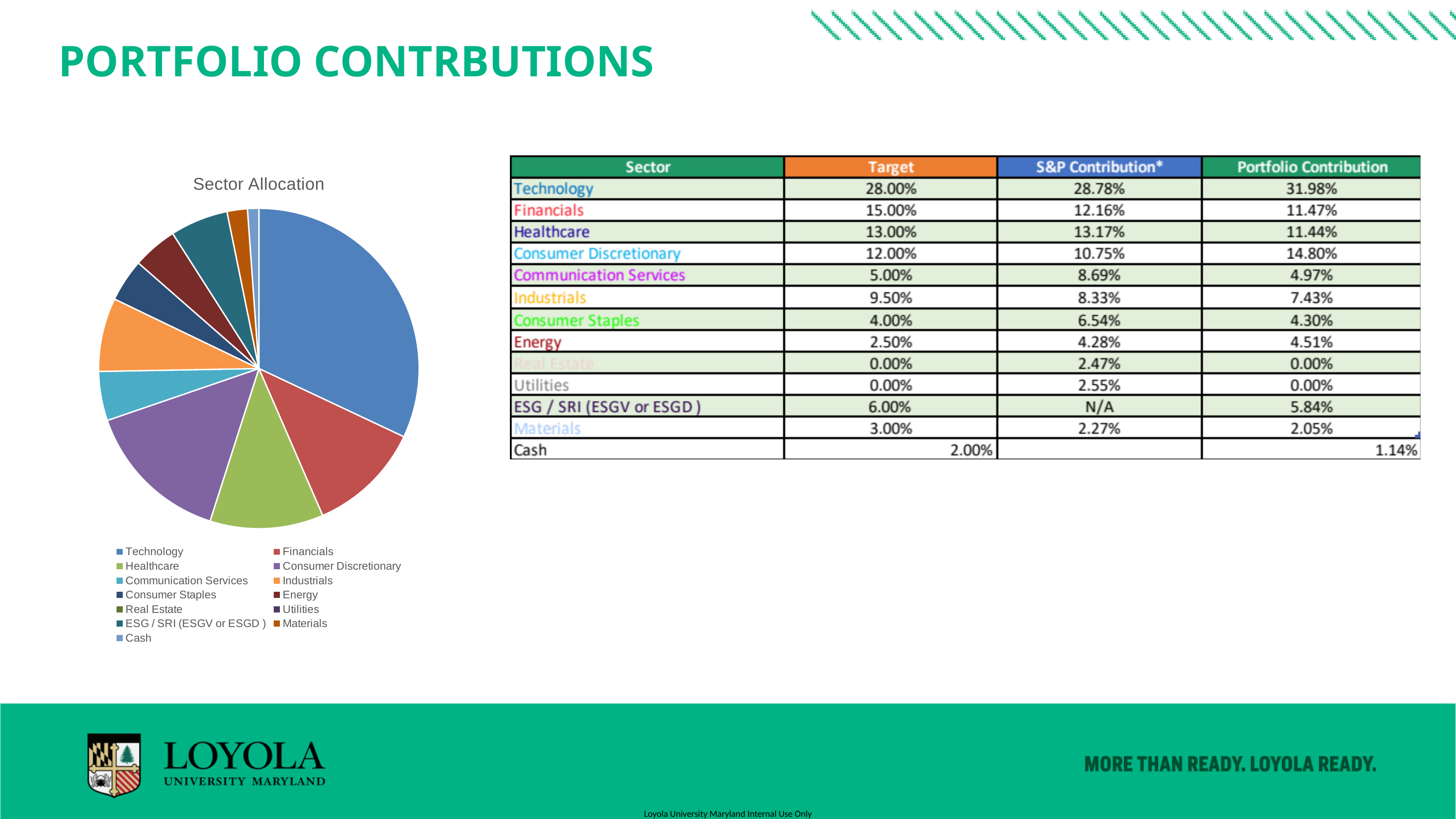
In the Sector Allocation pie chart, which slice is larger, Materials or Financials? Financials Which sector has the largest slice in the Sector Allocation pie chart? Technology What kind of chart is the Sector Allocation chart? pie chart In the Sector Allocation pie chart, which slice is larger, Industrials or Communication Services? Industrials In the Sector Allocation pie chart, which slice is larger, Technology or Financials? Technology What colour is the Technology slice in the Sector Allocation pie chart? blue What is the title of the pie chart on the left of the slide? Sector Allocation How many categories does the legend of the Sector Allocation pie chart list? 13